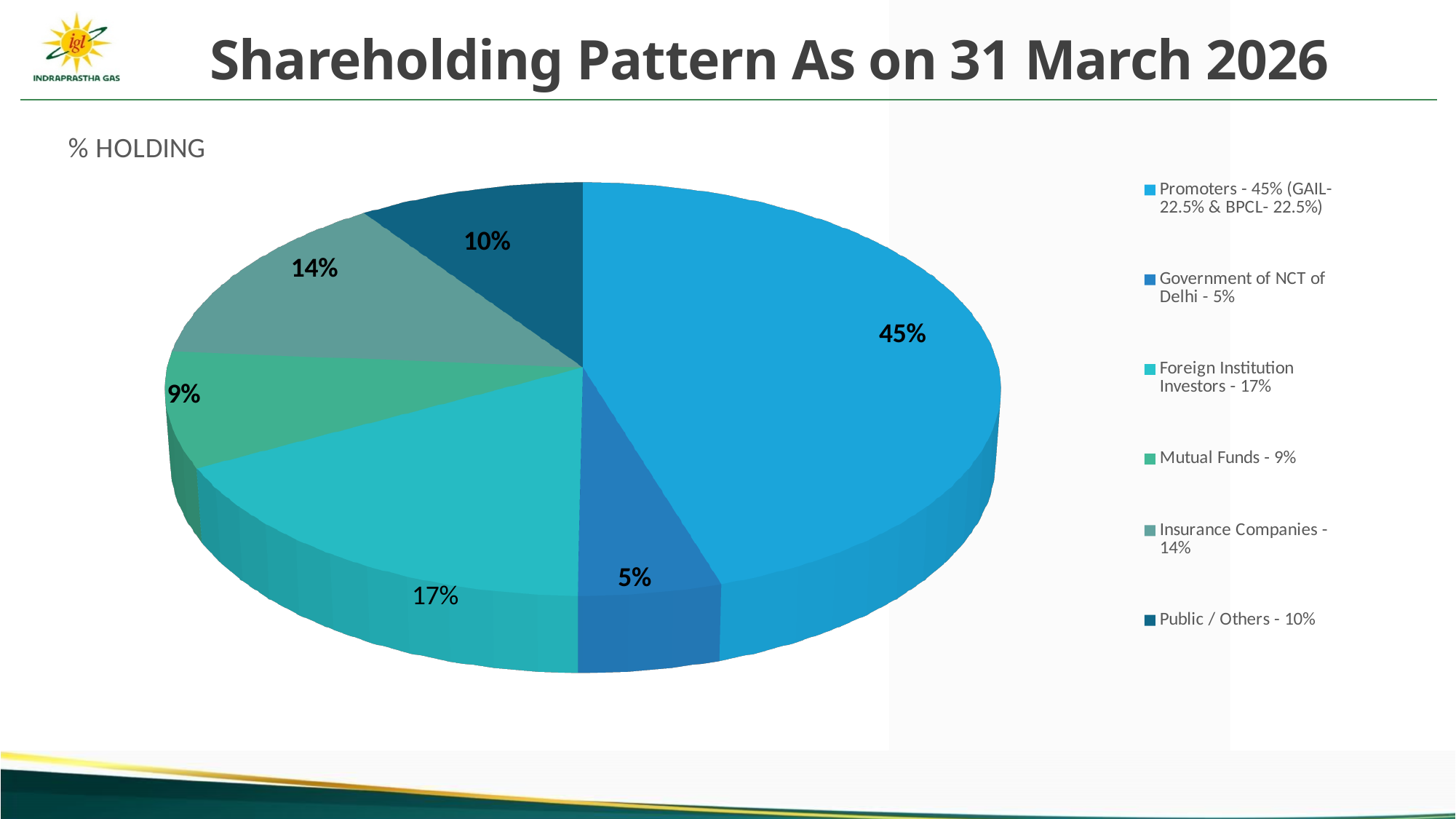
What is the share held by Insurance Companies? 14% What is the share held by the Government of NCT of Delhi? 5% What is the difference between the Foreign Institution Investors share and the Public / Others share? 7% How many categories does the pie chart have? 6 Which category holds the largest share of the pie? Promoters What is the share held by Foreign Institution Investors? 17% What type of chart is shown on the slide? Pie chart Which category holds the smallest share of the pie? Government of NCT of Delhi Which is larger, the Insurance Companies share or the Mutual Funds share? Insurance Companies What is the share held by Promoters? 45% What is the share held by Mutual Funds? 9% What is the chart's title shown above the pie? % HOLDING